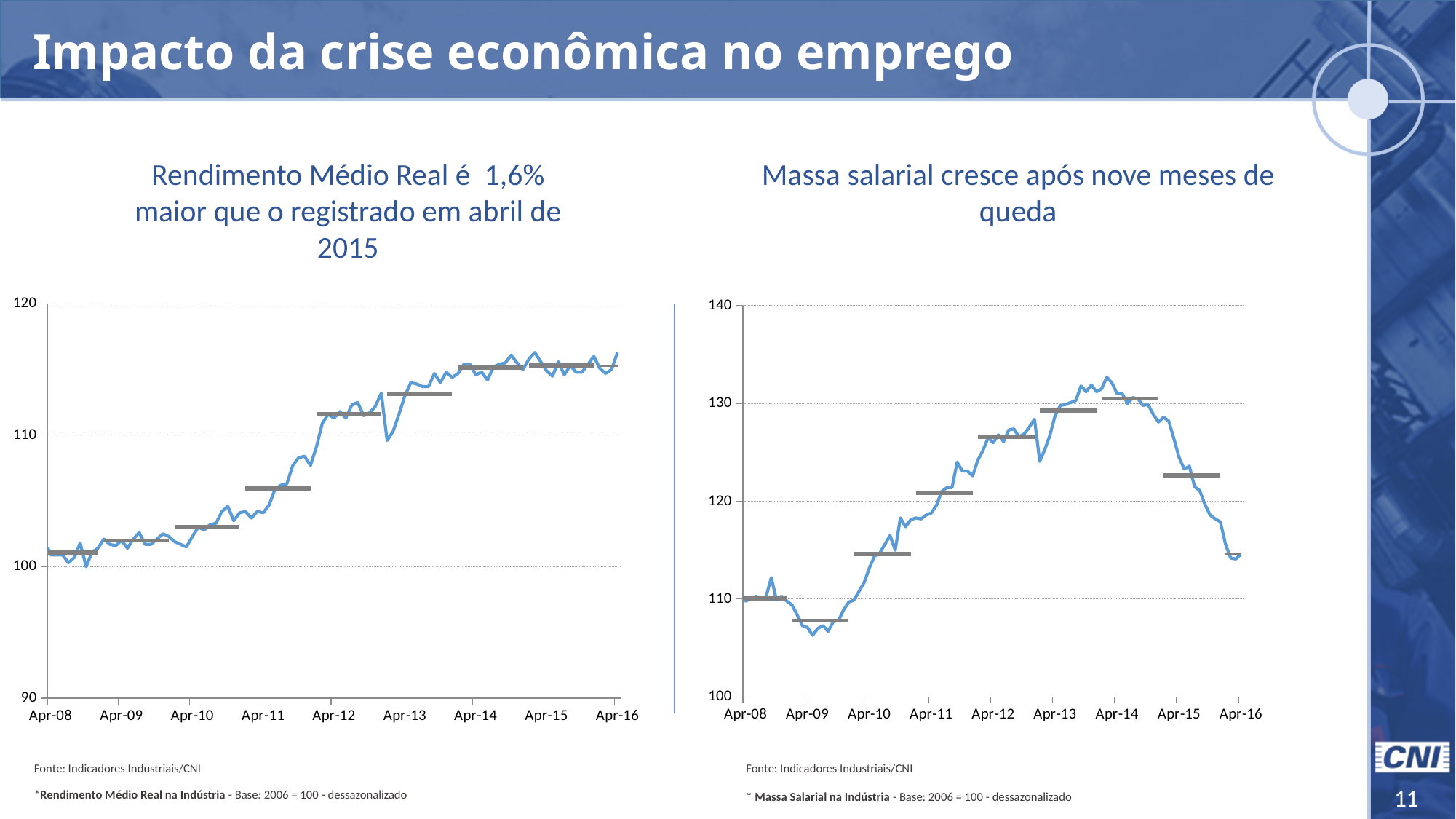
In the right chart (Massa salarial), is the value at Apr-16 greater or less than 120? less In the right chart (Massa salarial), do the values rise or fall from Apr-14 to Apr-16? fall How many year labels are shown on the x axis of the right chart (Massa salarial)? 9 In the right chart (Massa salarial), is the value at Apr-14 greater or less than 130? greater What source is cited below the left chart (Rendimento Médio Real)? Indicadores Industriais/CNI In the left chart (Rendimento Médio Real), is the value at Apr-16 greater or less than 110? greater What kind of chart is the right chart (Massa salarial)? line chart What kind of chart is the left chart (Rendimento Médio Real)? line chart What is the highest value shown on the y axis of the right chart (Massa salarial)? 140 In the left chart (Rendimento Médio Real), do the values generally rise or fall from Apr-08 to Apr-16? rise